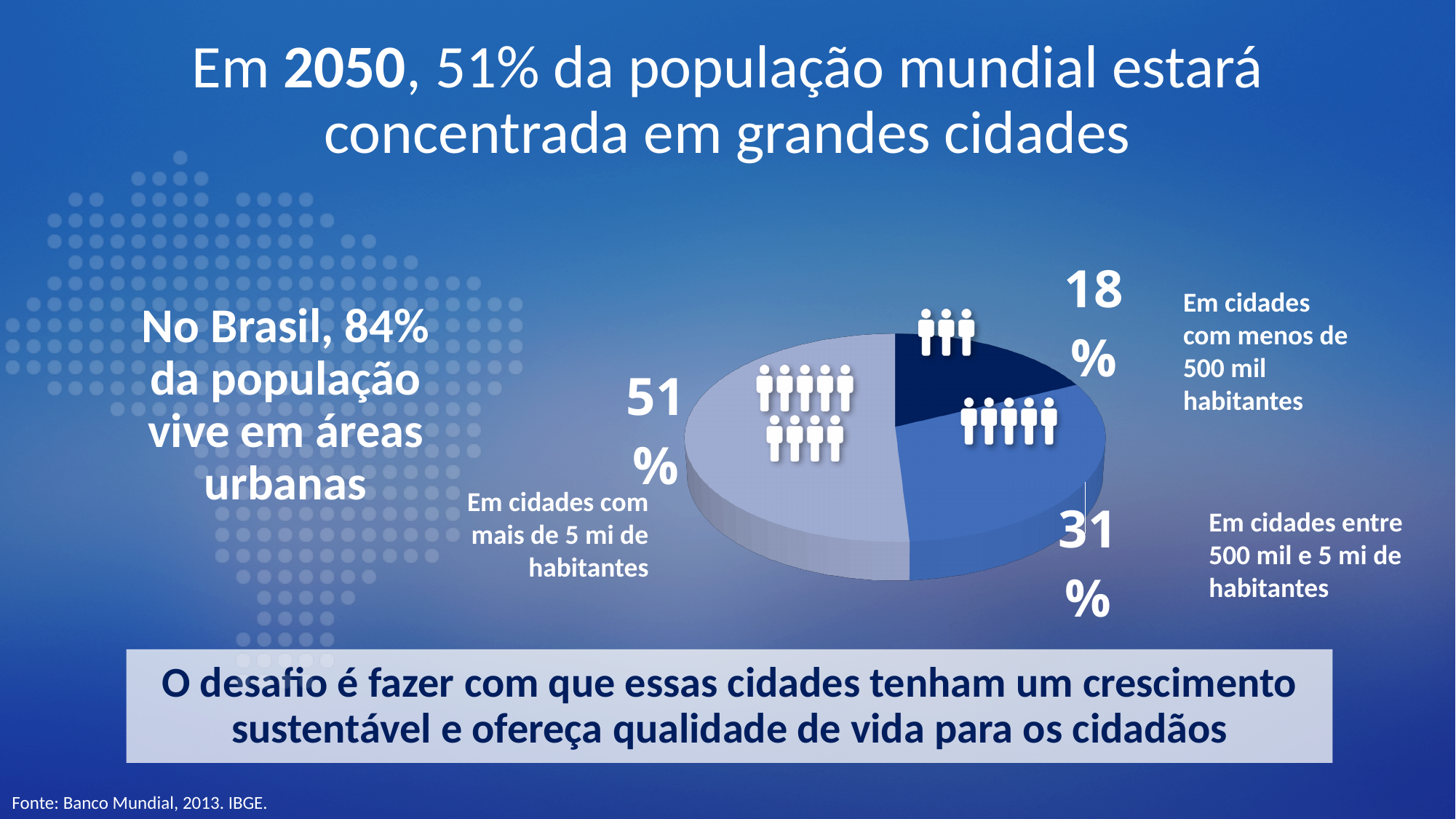
What share of the pie corresponds to cities with fewer than 500 thousand inhabitants ("Em cidades com menos de 500 mil habitantes")? 18% Which is larger: the slice for cities between 500 thousand and 5 million inhabitants or the slice for cities with fewer than 500 thousand inhabitants? Em cidades entre 500 mil e 5 mi de habitantes What share of the pie corresponds to cities between 500 thousand and 5 million inhabitants ("Em cidades entre 500 mil e 5 mi de habitantes")? 31% What kind of chart is shown on the slide? pie chart How many slices does the pie chart have? 3 Which category has the smallest slice of the pie chart? Em cidades com menos de 500 mil habitantes What is the difference in percentage points between the slice for cities between 500 thousand and 5 million inhabitants and the slice for cities with fewer than 500 thousand inhabitants? 13 What share of the pie corresponds to cities with more than 5 million inhabitants ("Em cidades com mais de 5 mi de habitantes")? 51% What is the difference in percentage points between the slice for cities with more than 5 million inhabitants and the slice for cities between 500 thousand and 5 million inhabitants? 20 What is the combined share of the two smaller slices (cities with fewer than 500 thousand inhabitants and cities between 500 thousand and 5 million inhabitants)? 49% Which category has the largest slice of the pie chart? Em cidades com mais de 5 mi de habitantes Which slice of the pie chart is drawn in the darkest blue? Em cidades com menos de 500 mil habitantes (18%)